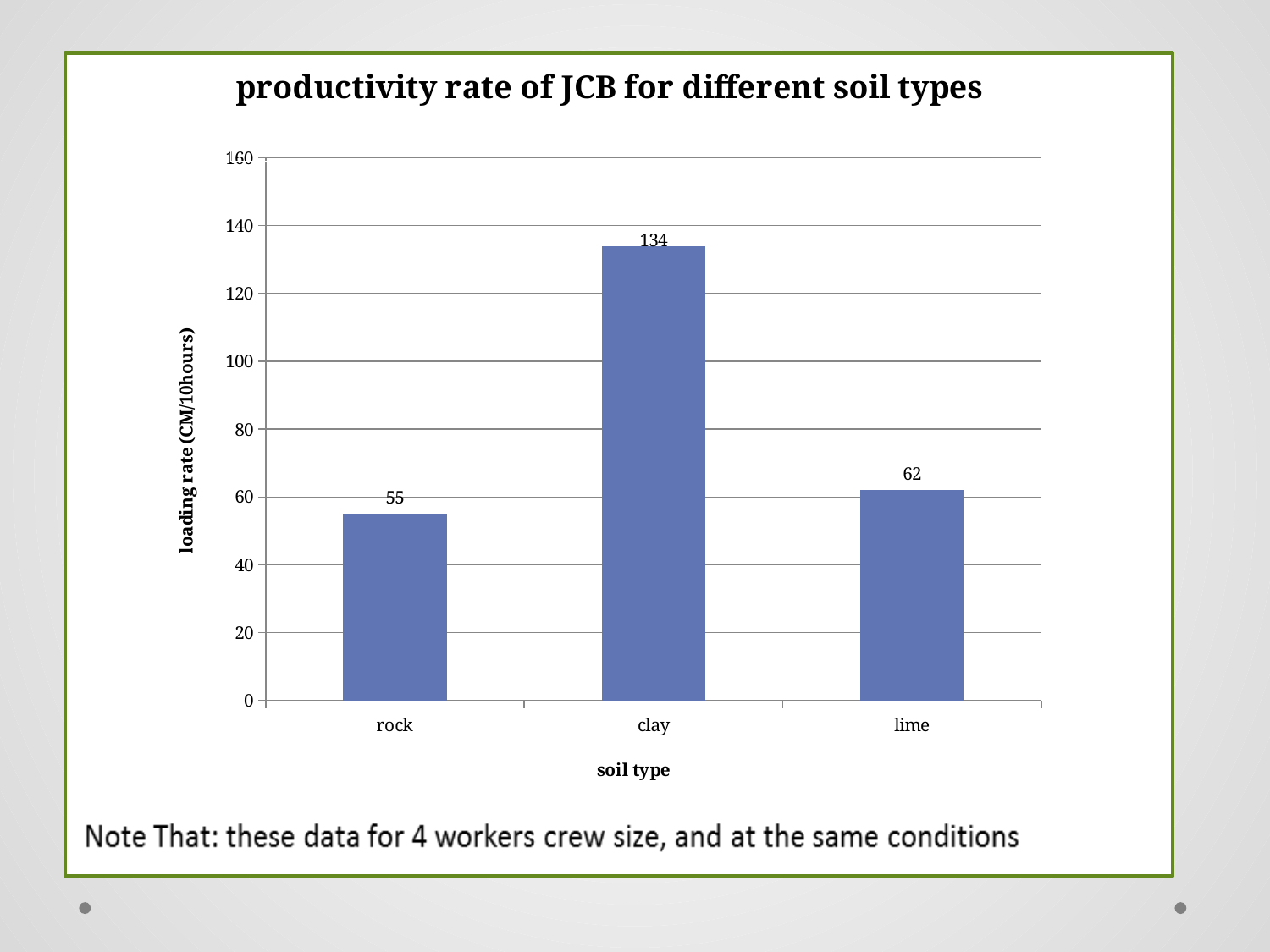
How many soil types are shown on the chart? 3 What is the loading rate for clay? 134 Which soil type has the highest loading rate? clay Is the value for clay greater or less than 120? greater Which soil type has the lowest loading rate? rock Which has a higher loading rate, lime or rock? lime What kind of chart is shown on the slide? bar chart What is the title of the chart? productivity rate of JCB for different soil types What is the difference between the loading rates for lime and rock? 7 What is the difference between the loading rates for clay and rock? 79 What is the loading rate for rock? 55 What is the loading rate for lime? 62